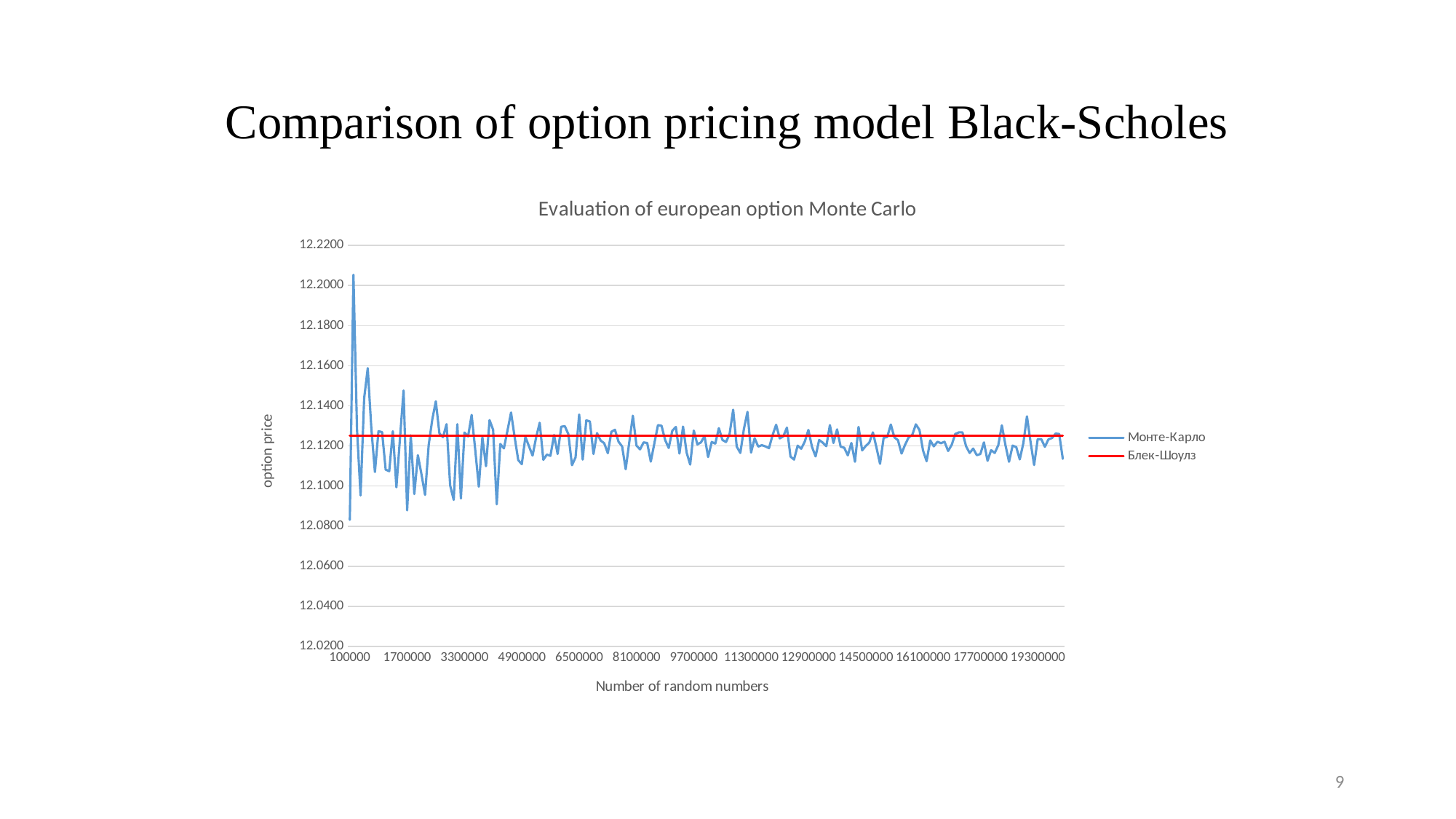
What is the first value shown on the x axis of the chart? 100000 Is the value of the Блек-Шоулз line greater or less than 12.1200? greater Do the fluctuations of the Монте-Карло series get larger or smaller as the number of random numbers increases? smaller What kind of chart is shown on the slide? Line chart How many series does the legend of the chart list? 2 Is the value of the Блек-Шоулз line greater or less than 12.1400? less Is the highest value of the Монте-Карло series greater or less than 12.1800? greater Does the Блек-Шоулз line rise, fall, or stay flat along the x axis? stay flat What is the label of the x axis of the chart? Number of random numbers Which series reaches the highest value on the chart, Монте-Карло or Блек-Шоулз? Монте-Карло What is the title of the chart? Evaluation of european option Monte Carlo